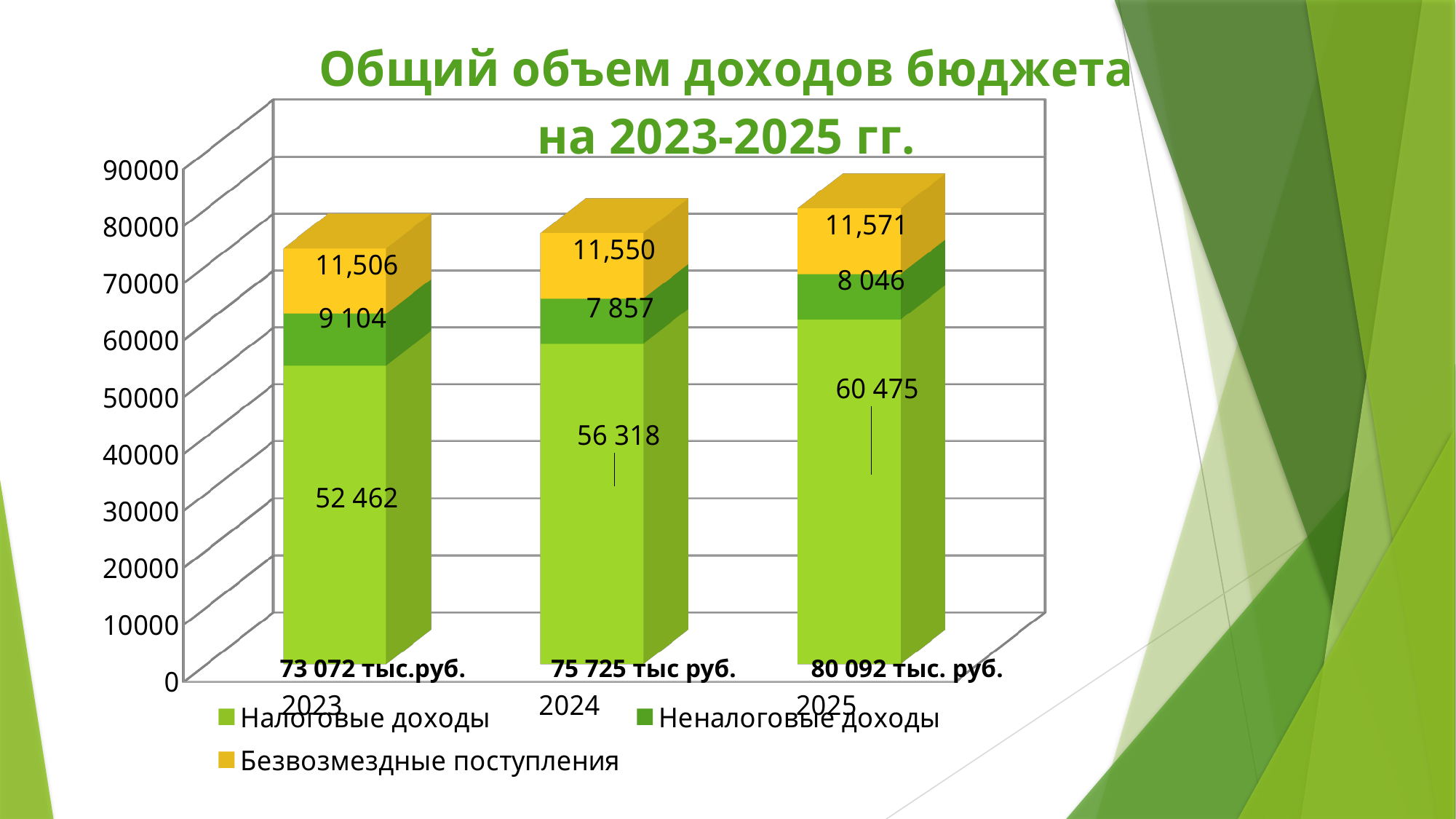
How many series does the legend list? 3 What is the total of the stacked bar for 2023? 73 072 тыс.руб. What is the value of Безвозмездные поступления for 2025? 11,571 In which year is the value of Неналоговые доходы lowest? 2024 What is the value of Неналоговые доходы for 2024? 7 857 In which year is the value of Налоговые доходы highest? 2025 Which is larger: Неналоговые доходы in 2023 or in 2024? 2023 What is the value of Налоговые доходы for 2023? 52 462 Do the values of Налоговые доходы rise or fall from 2023 to 2025? Rise How many years are shown on the x axis? 3 What is the difference between Налоговые доходы in 2025 and in 2023? 8 013 What kind of chart is shown on the slide? Stacked bar chart